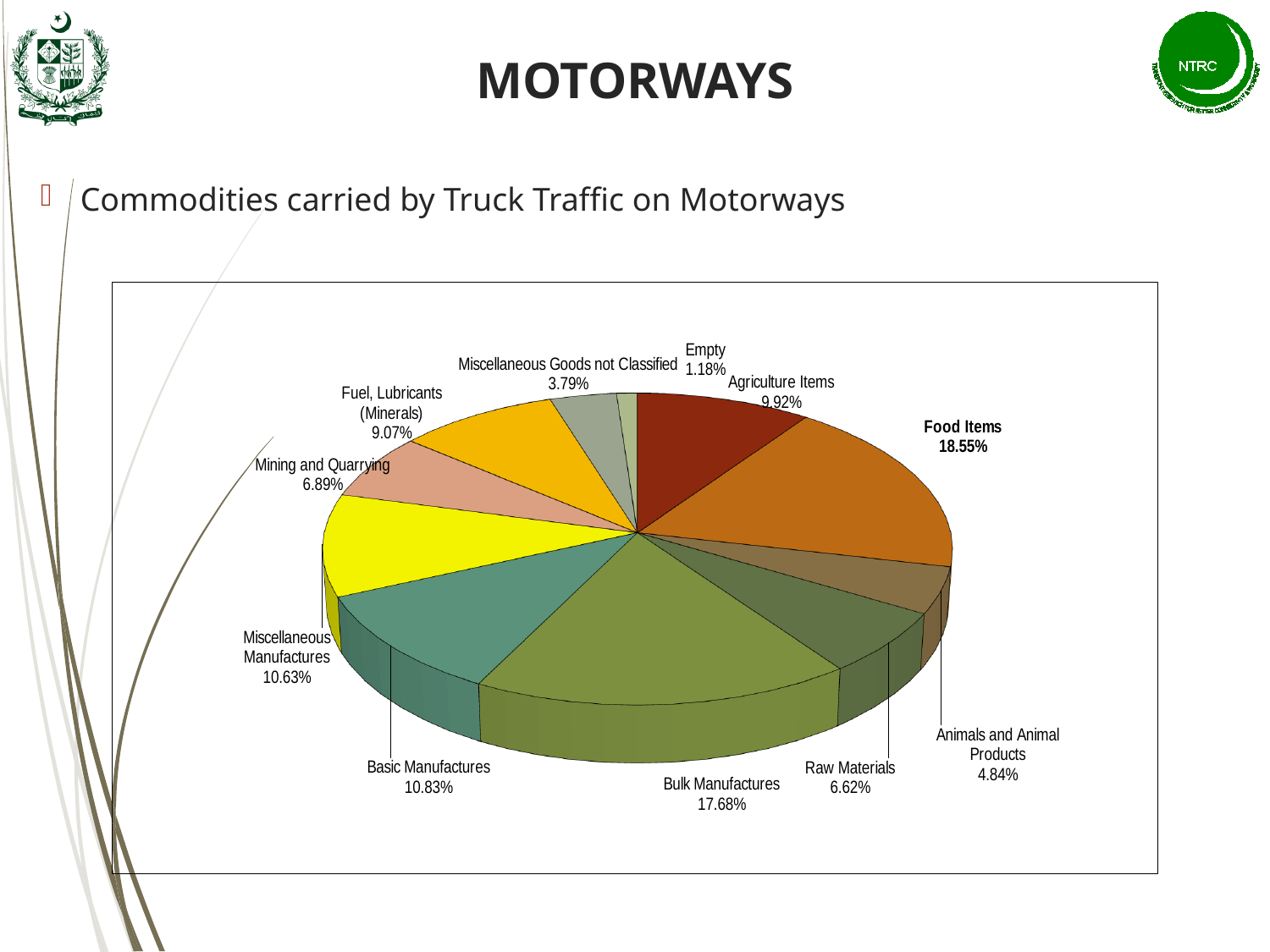
How many commodity categories are shown in the pie chart? 11 What is the share for Mining and Quarrying? 6.89% What percentage is shown for Animals and Animal Products? 4.84% Which commodity category has the largest share of truck traffic on motorways? Food Items Which category has the smallest share in the pie chart? Empty What percentage is shown for Agriculture Items? 9.92% What does the pie chart on the slide describe, according to the text above it? Commodities carried by Truck Traffic on Motorways What is the share for Fuel, Lubricants (Minerals)? 9.07% What kind of chart is shown on the slide? Pie chart Which has a larger share, Basic Manufactures or Miscellaneous Manufactures? Basic Manufactures How many percentage points larger is the Food Items share than the Bulk Manufactures share? 0.87 percentage points What share of truck traffic is Bulk Manufactures? 17.68%